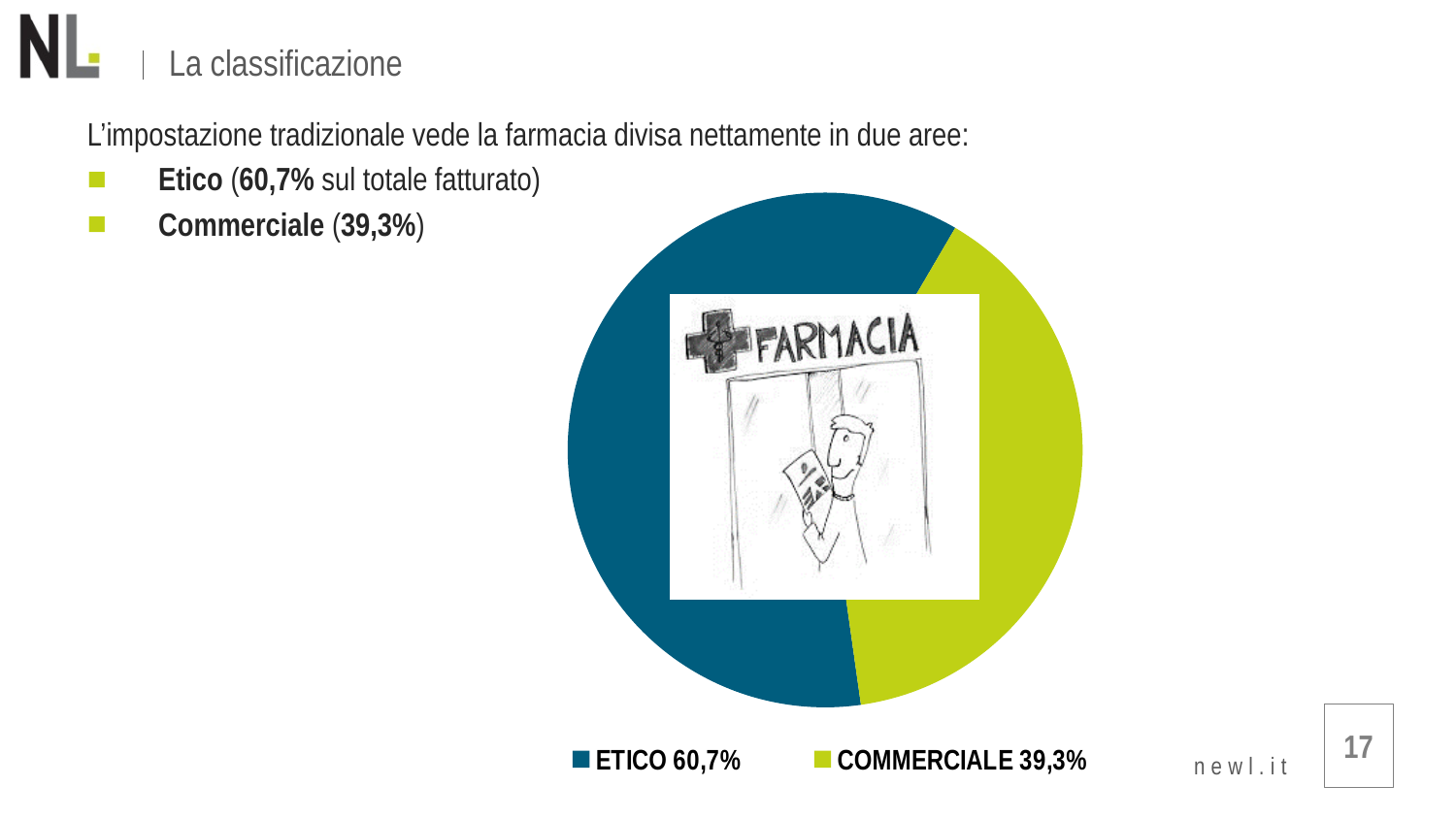
What kind of chart is shown on the slide? Pie chart What share of the pie does ETICO represent? 60,7% Which is larger, the ETICO slice or the COMMERCIALE slice? ETICO What share of the pie does COMMERCIALE represent? 39,3% What colour is the COMMERCIALE slice in the pie chart? Green What colour is the ETICO slice in the pie chart? Dark blue (teal) What is the difference in percentage points between the ETICO and COMMERCIALE slices? 21,4 Is the share for ETICO greater or less than 50%? greater How many entries does the legend of the pie chart list? 2 How many slices does the pie chart have? 2 Which slice of the pie chart is the largest? ETICO Which slice of the pie chart is the smallest? COMMERCIALE